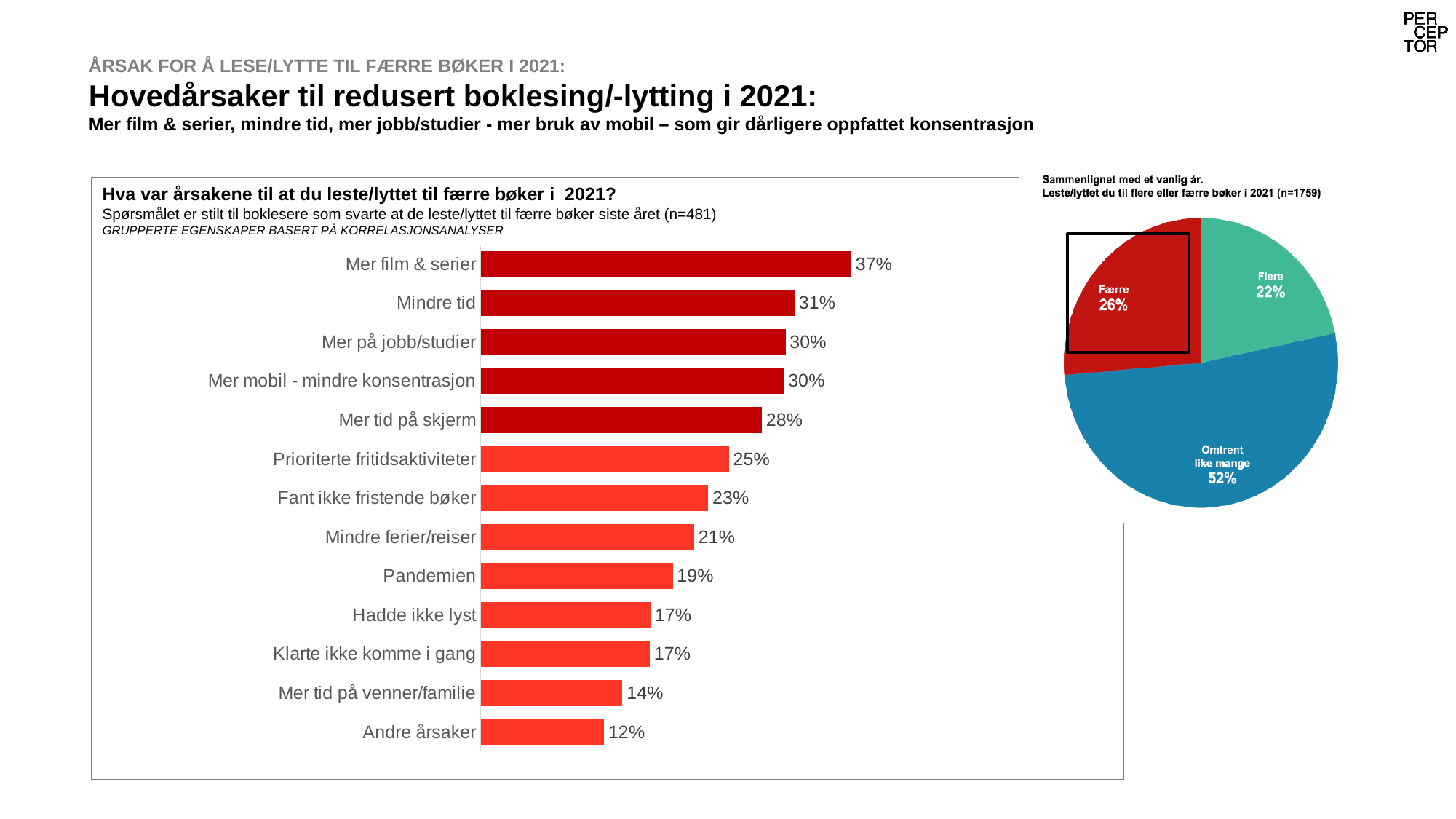
What kind of chart is the chart on the right? Pie chart In the bar chart on the left, what is the value for "Pandemien"? 19% In the bar chart on the left, which category has the highest value? Mer film & serier In the bar chart on the left, what is the value for "Mer film & serier"? 37% How many categories are shown in the bar chart on the left? 13 In the pie chart on the right, which slice is the largest? Omtrent like mange What kind of chart is the chart on the left? Bar chart In the pie chart on the right, what is the difference between "Færre" and "Flere"? 4 percentage points In the bar chart on the left, which category has the lowest value? Andre årsaker In the pie chart on the right, what share is labelled "Færre"? 26% In the bar chart on the left, what is the difference between "Mer film & serier" and "Mindre tid"? 6 percentage points In the bar chart on the left, which is larger: "Fant ikke fristende bøker" or "Mindre ferier/reiser"? Fant ikke fristende bøker